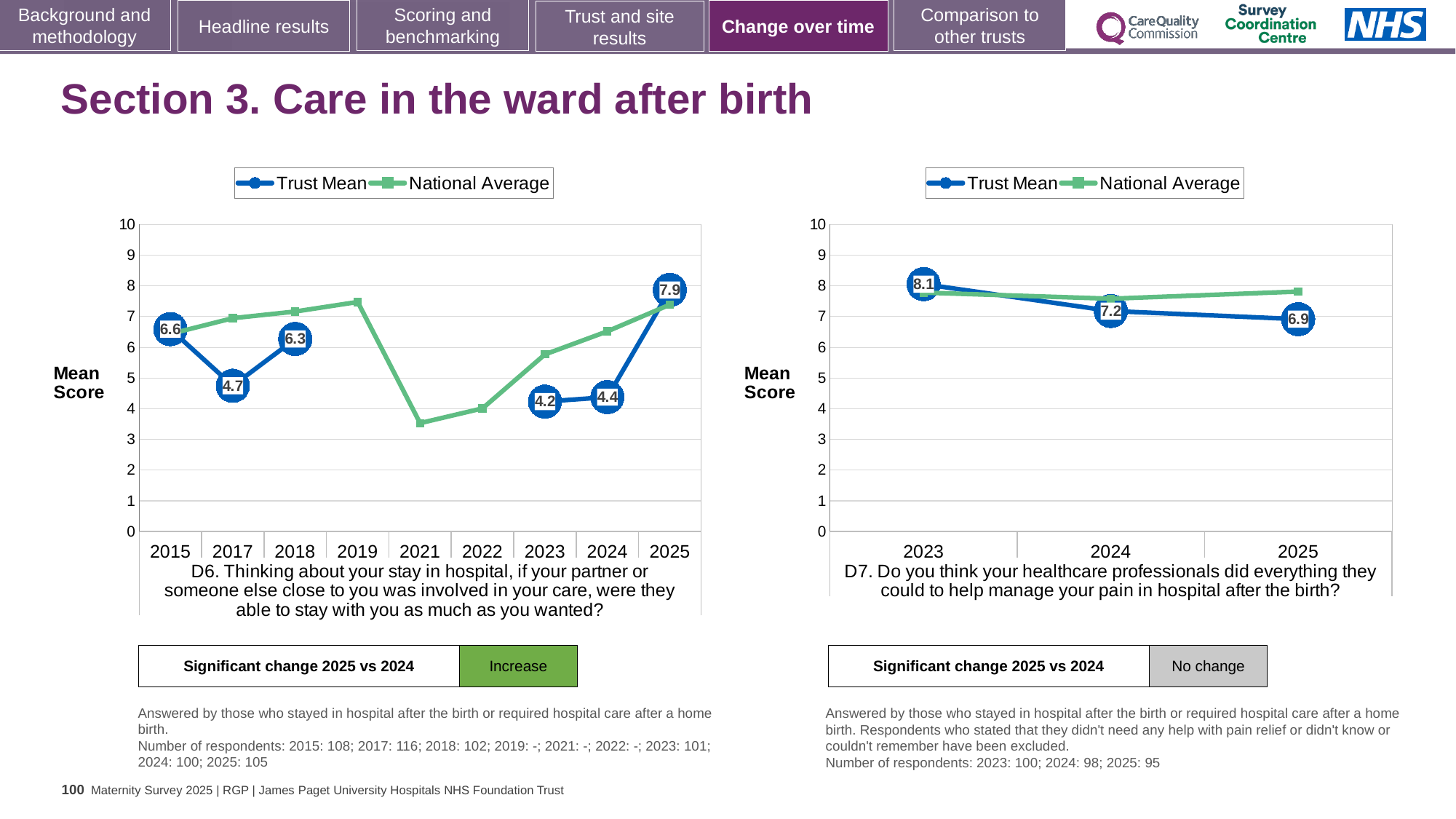
In the D6 chart on the left, what is the Trust Mean for 2025? 7.9 In the D6 chart on the left, which year has the lowest Trust Mean? 2023 In the D6 chart on the left, is the National Average for 2021 greater or less than 4? less In the D7 chart on the right, what is the Trust Mean for 2025? 6.9 In the D7 chart on the right, does the Trust Mean rise or fall from 2023 to 2025? fall In the D7 chart on the right, what is the difference between the Trust Mean for 2023 and the Trust Mean for 2025? 1.2 How many series does the legend of the D7 chart on the right list? 2 In the D6 chart on the left, what is the difference between the Trust Mean for 2025 and the Trust Mean for 2024? 3.5 In the D6 chart on the left, is the Trust Mean for 2015 or for 2018 larger? 2015 In the D7 chart on the right, what is the Trust Mean for 2023? 8.1 In the D6 chart on the left, what is the Trust Mean for 2017? 4.7 In the D6 chart on the left, which year has the highest Trust Mean? 2025